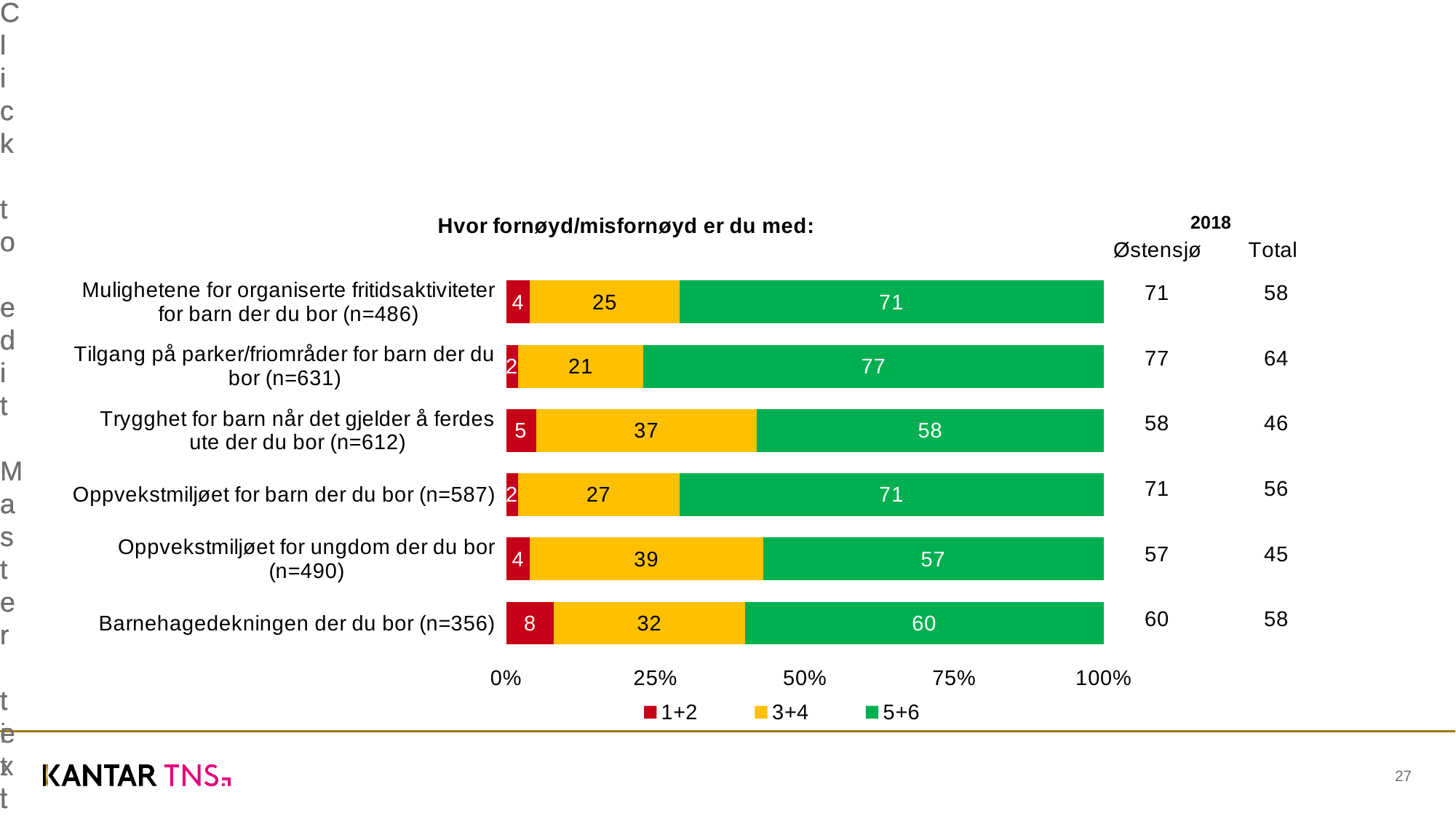
What is the value of the 3+4 series for "Oppvekstmiljøet for ungdom der du bor (n=490)"? 39 Which category has the lowest value for the 5+6 series? Oppvekstmiljøet for ungdom der du bor (n=490) What is the value of the 5+6 series for "Tilgang på parker/friområder for barn der du bor (n=631)"? 77 Which is larger: the 3+4 value for "Trygghet for barn når det gjelder å ferdes ute der du bor (n=612)" or the 3+4 value for "Barnehagedekningen der du bor (n=356)"? Trygghet for barn når det gjelder å ferdes ute der du bor (n=612) How many series does the legend list? 3 What is the difference between the 5+6 values for "Tilgang på parker/friområder for barn der du bor (n=631)" and "Trygghet for barn når det gjelder å ferdes ute der du bor (n=612)"? 19 How many categories are shown in the chart? 6 What kind of chart is shown on the slide? Stacked bar chart Which category has the highest value for the 1+2 series? Barnehagedekningen der du bor (n=356) What is the total of the stacked bar for "Oppvekstmiljøet for barn der du bor (n=587)"? 100 What is the value of the 1+2 series for "Barnehagedekningen der du bor (n=356)"? 8 Which category has the highest value for the 5+6 series? Tilgang på parker/friområder for barn der du bor (n=631)